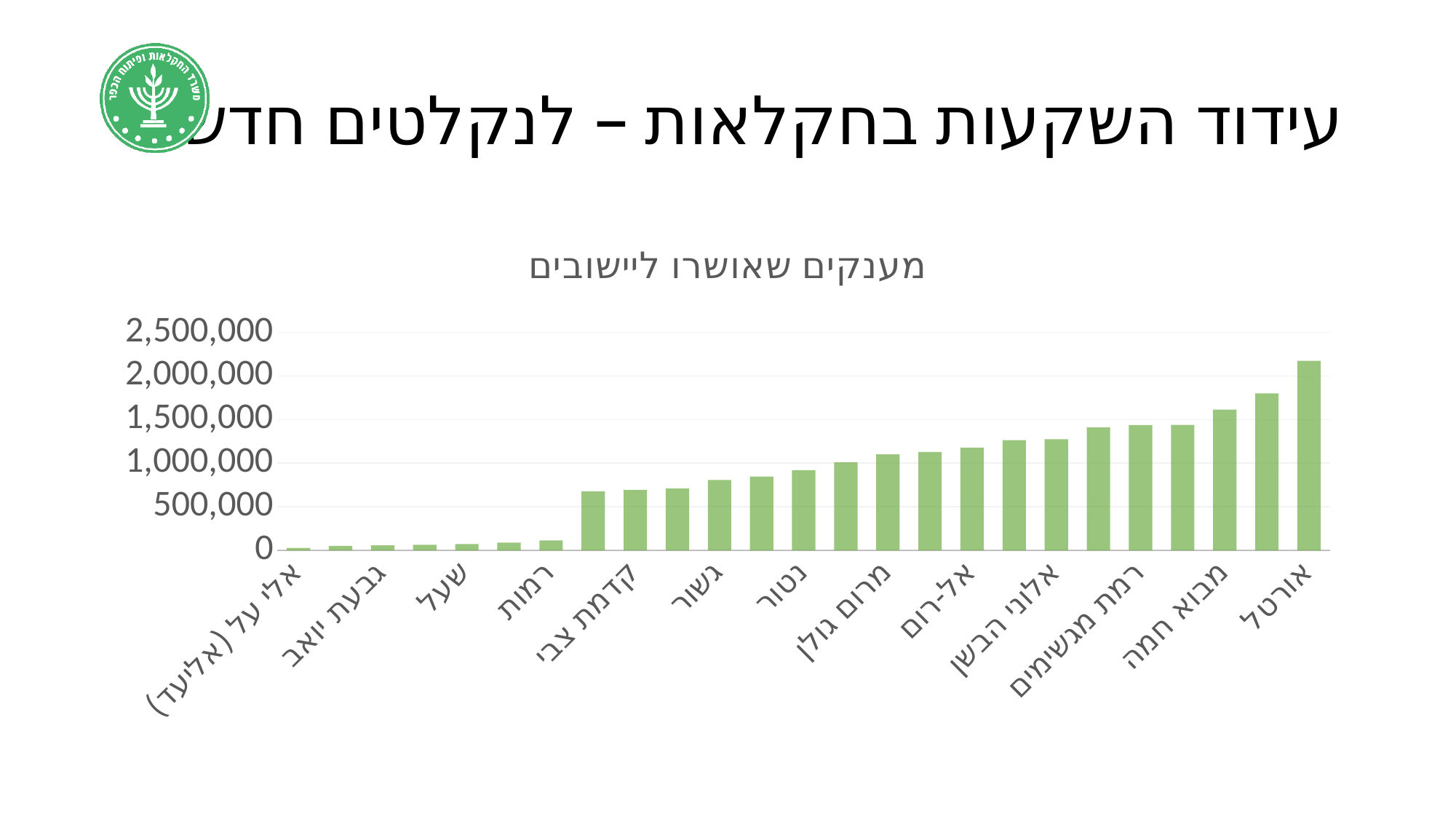
Is the value for נטור greater or less than 1,000,000? less Which has a larger value, אורטל or גשור? אורטל What type of chart is shown on the slide? bar chart Is the value for אורטל greater or less than 2,000,000? greater Is the value for מבוא חמה greater or less than 1,500,000? greater Which category has the highest value in the chart? אורטל Which category has the lowest value in the chart? אלי על (אליעד) Do the bar values rise or fall from left to right along the x axis? rise What is the title of the chart? מענקים שאושרו ליישובים